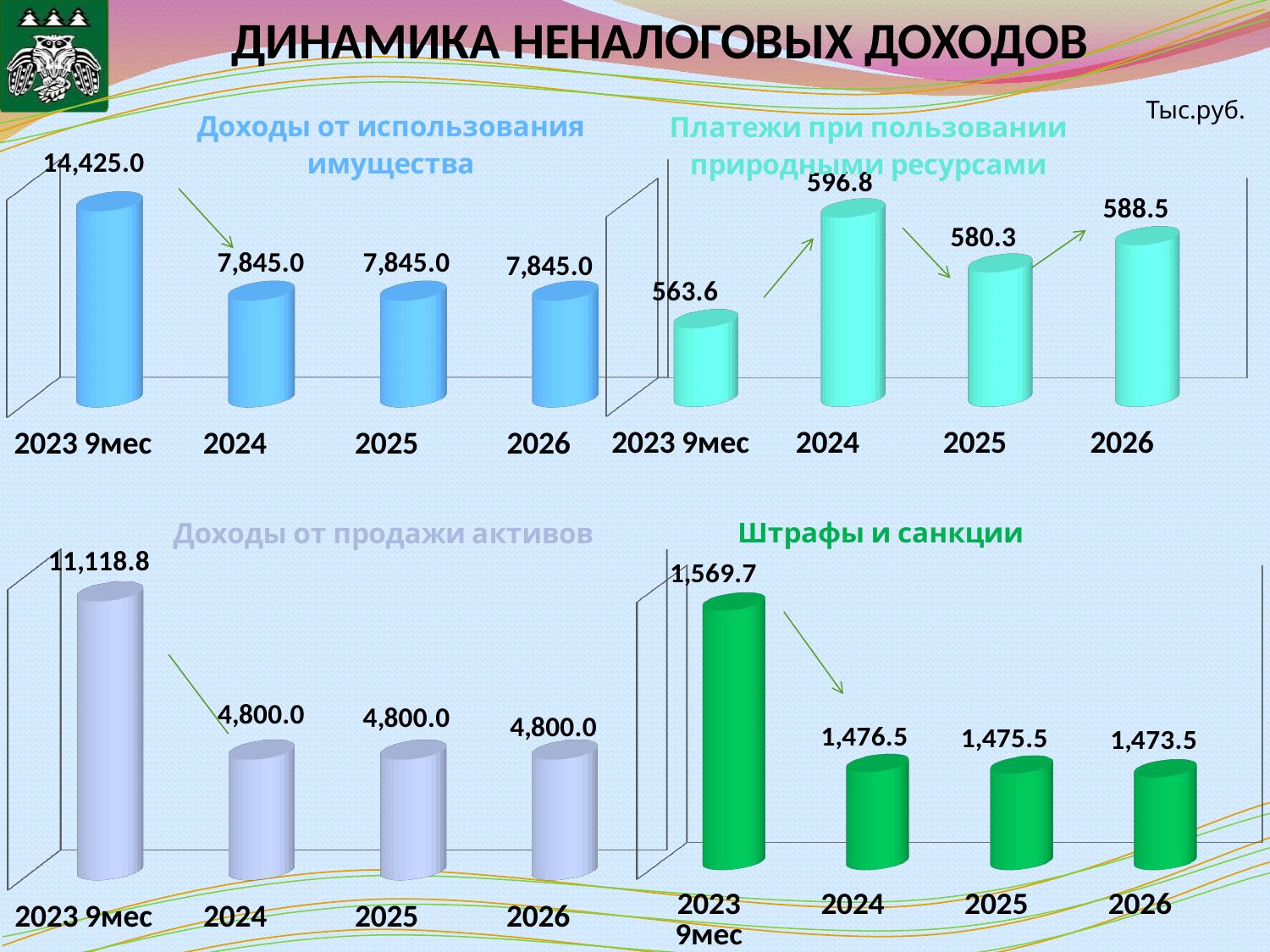
How many categories are shown in the chart 'Доходы от использования имущества'? 4 In the chart 'Доходы от продажи активов', what is the difference between the 2023 9мес value and the 2024 value? 6,318.8 In the chart 'Платежи при пользовании природными ресурсами', which year has the highest value? 2024 In the chart 'Платежи при пользовании природными ресурсами', what is the value for 2026? 588.5 In the chart 'Платежи при пользовании природными ресурсами', what is the difference between the 2024 and 2025 values? 16.5 In the chart 'Доходы от продажи активов', what is the value for 2023 9мес? 11,118.8 What kind of chart is 'Штрафы и санкции'? bar chart In the chart 'Доходы от использования имущества', what is the value for 2023 9мес? 14,425.0 In the chart 'Штрафы и санкции', what is the value for 2025? 1,475.5 In the chart 'Штрафы и санкции', which year has the lowest value? 2026 In the chart 'Штрафы и санкции', is the value for 2024 larger or smaller than the value for 2023 9мес? smaller In the chart 'Доходы от использования имущества', what is the value for 2025? 7,845.0